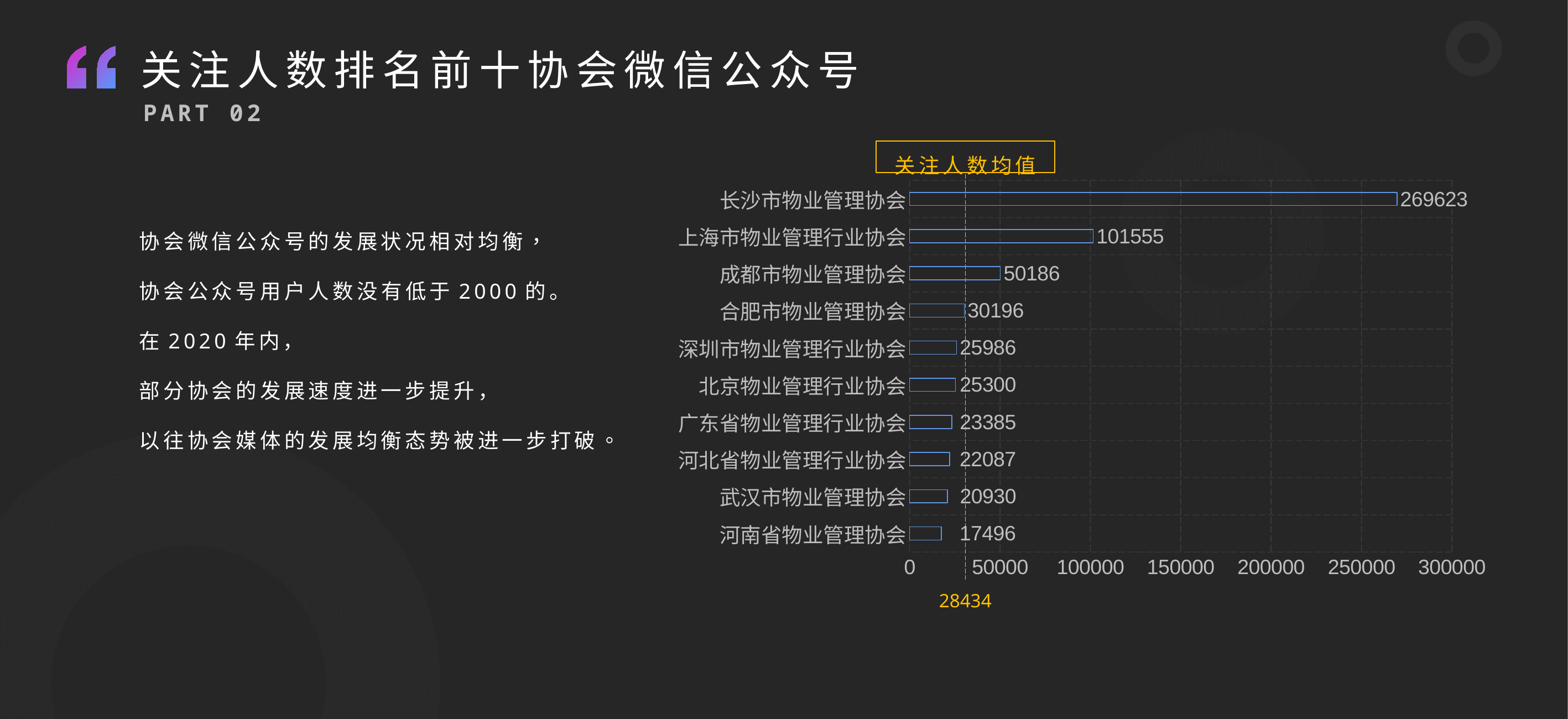
How many associations are plotted in the chart? 10 What is the difference between the values for 成都市物业管理协会 and 合肥市物业管理协会? 19990 Which association has the highest value in the chart? 长沙市物业管理协会 What average value (关注人数均值) is marked by the dashed line in the chart? 28434 Is the value for 武汉市物业管理协会 greater or less than 50000? less Which is larger, the value for 成都市物业管理协会 or the value for 合肥市物业管理协会? 成都市物业管理协会 What is the value for 长沙市物业管理协会? 269623 What kind of chart is shown on the slide? bar chart What is the difference between the values for 长沙市物业管理协会 and 上海市物业管理行业协会? 168068 What is the value for 河北省物业管理行业协会? 22087 Which association has the lowest value in the chart? 河南省物业管理协会 What is the value for 上海市物业管理行业协会? 101555